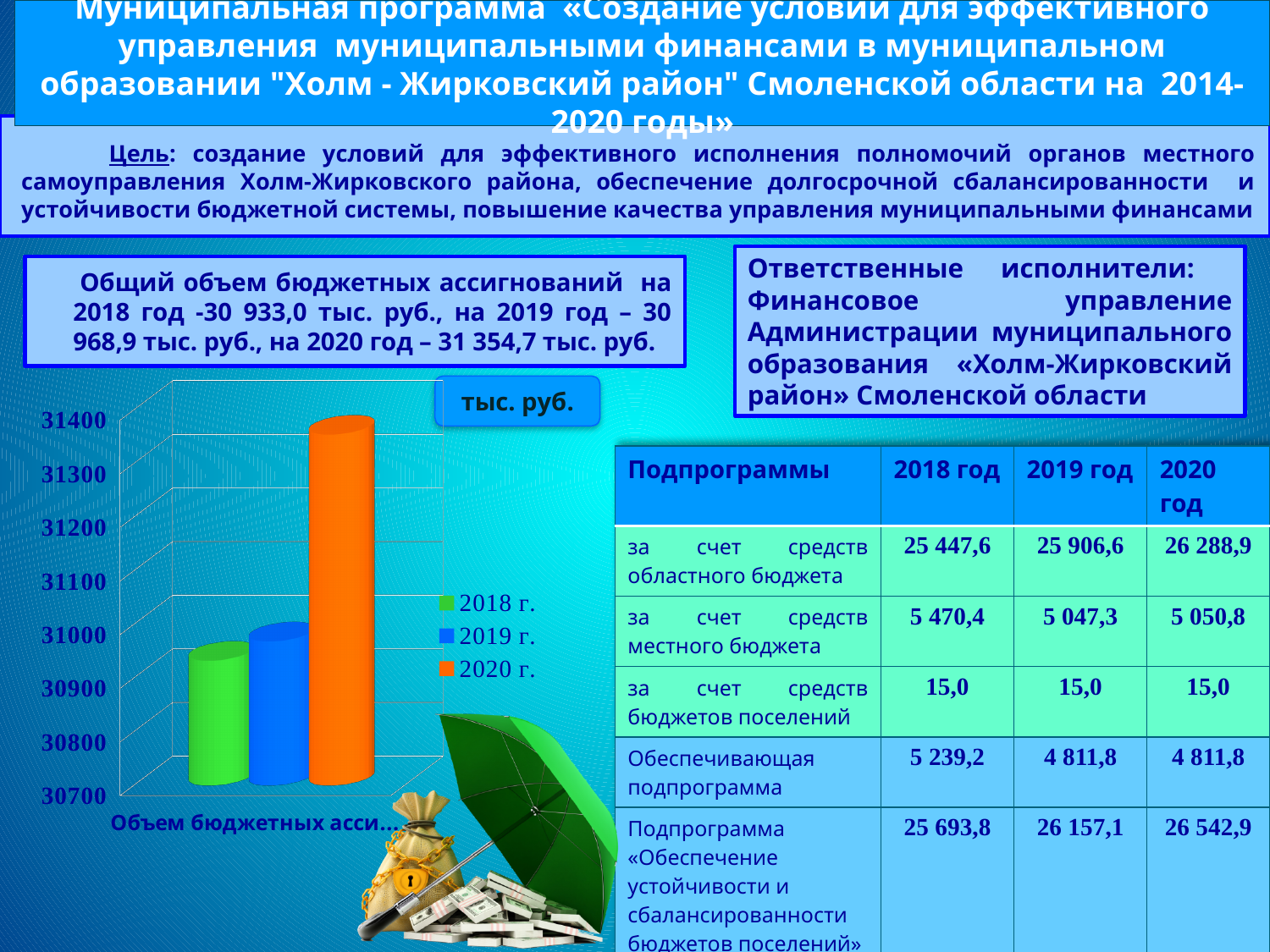
What unit is shown in the label above the chart? тыс. руб. Which bar is taller, 2020 г. or 2019 г.? 2020 г. How many series does the chart legend list? 3 Which year has the highest bar in the chart? 2020 г. Is the bar for 2018 г. greater or less than 31000? less Which year has the lowest bar in the chart? 2018 г. Is the bar for 2020 г. greater or less than 31300? greater Which bar is taller, 2019 г. or 2018 г.? 2019 г. What kind of chart is shown on the slide? bar chart What colour is the bar for 2020 г. in the chart? orange Is the bar for 2019 г. greater or less than 30900? greater